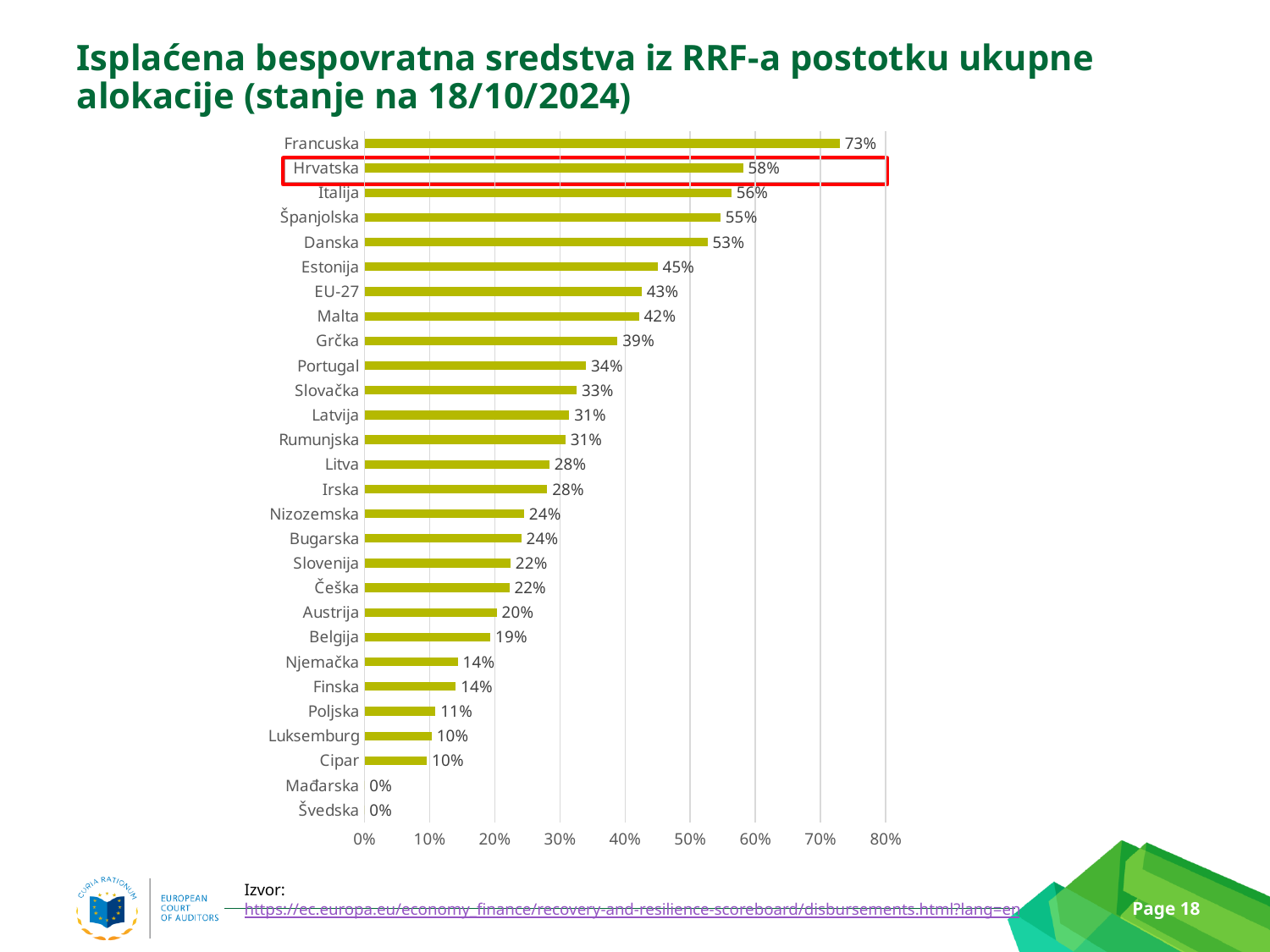
What is the value for EU-27? 43% What is the difference between the values for Francuska and Hrvatska? 15% What kind of chart is shown on the slide? Bar chart What is the value for Hrvatska? 58% Which category is highlighted with a red box on the chart? Hrvatska What value is shown for Švedska? 0% Which is larger, the value for Belgija or the value for Njemačka? Belgija What is the value for Poljska? 11% How many categories are shown on the chart? 28 Which category has the highest value? Francuska What is the difference between the values for Hrvatska and EU-27? 15% Which is larger, the value for Estonija or the value for Malta? Estonija